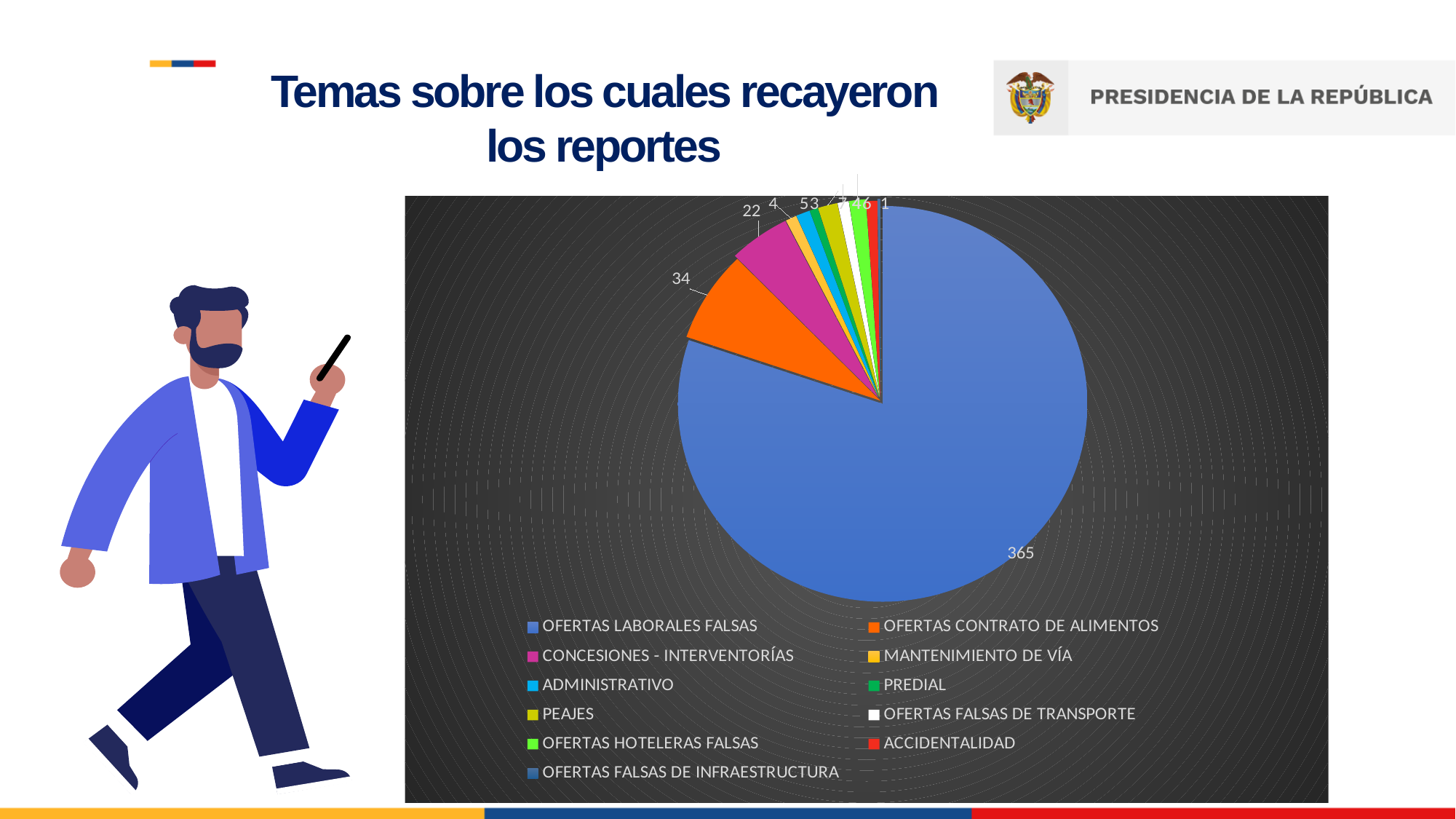
What is the value for OFERTAS LABORALES FALSAS? 365 How many categories does the legend list? 11 What is the value for CONCESIONES - INTERVENTORÍAS? 22 What kind of chart is shown on the slide? pie chart What colour is the slice for OFERTAS LABORALES FALSAS? blue What is the difference between the values for OFERTAS LABORALES FALSAS and OFERTAS CONTRATO DE ALIMENTOS? 331 Which is larger, OFERTAS CONTRATO DE ALIMENTOS or CONCESIONES - INTERVENTORÍAS? OFERTAS CONTRATO DE ALIMENTOS What is the value for OFERTAS CONTRATO DE ALIMENTOS? 34 Which category has the largest slice of the pie? OFERTAS LABORALES FALSAS What is the difference between the values for OFERTAS CONTRATO DE ALIMENTOS and CONCESIONES - INTERVENTORÍAS? 12 What is the title of the slide containing the chart? Temas sobre los cuales recayeron los reportes